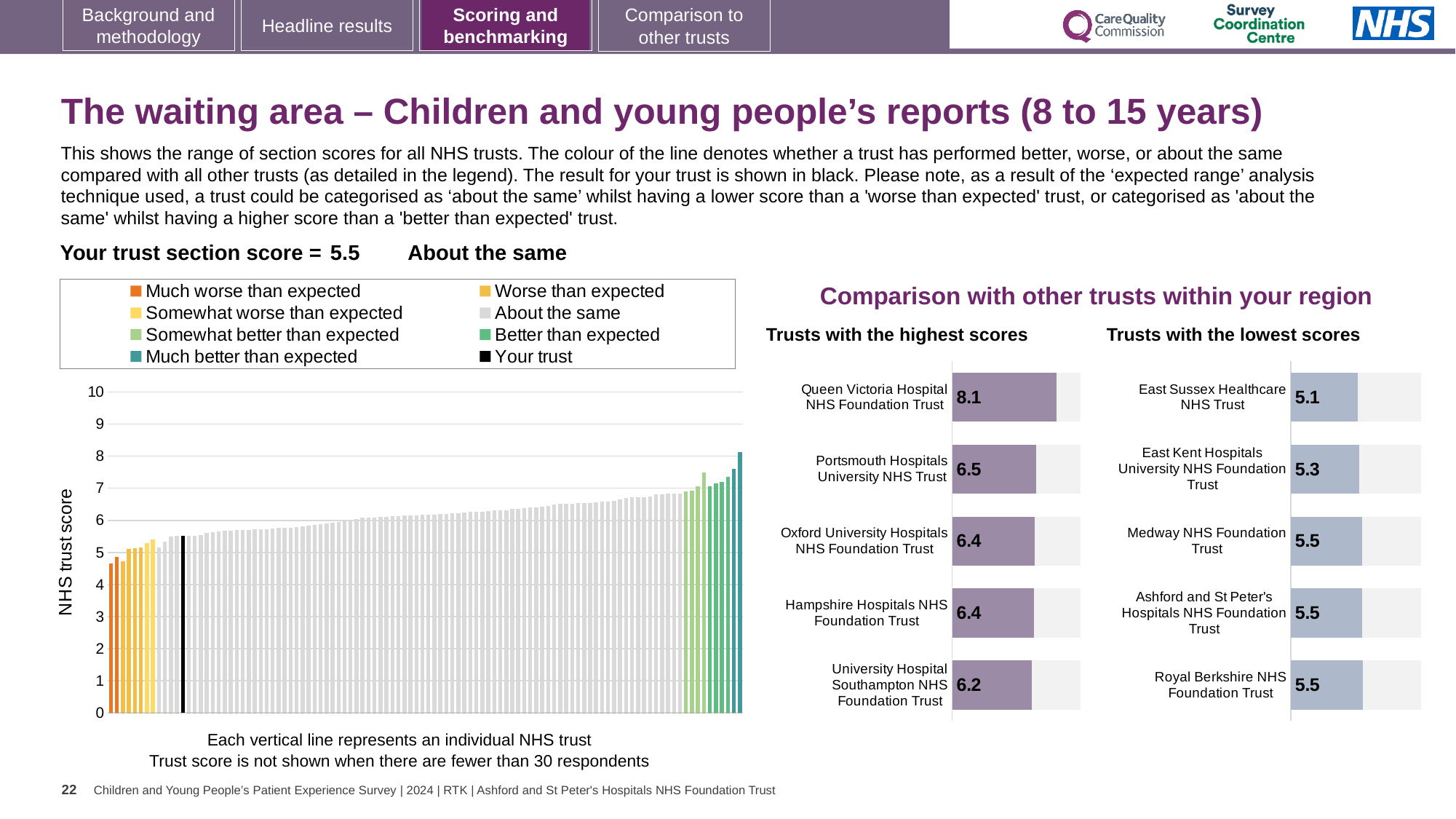
On the 'Trusts with the lowest scores' chart, what is the difference between the scores of Royal Berkshire NHS Foundation Trust and East Sussex Healthcare NHS Trust? 0.4 On the 'Trusts with the lowest scores' chart, how many trusts are listed? 5 On the 'Trusts with the highest scores' chart, what is the difference between the scores of Queen Victoria Hospital NHS Foundation Trust and Portsmouth Hospitals University NHS Trust? 1.6 On the 'Trusts with the highest scores' chart, which trust has the highest score? Queen Victoria Hospital NHS Foundation Trust On the 'Trusts with the lowest scores' chart, which trust has the lowest score? East Sussex Healthcare NHS Trust On the large 'NHS trust score' chart on the left, do the bar values rise or fall from left to right? rise On the 'Trusts with the highest scores' chart, which has the higher score: Portsmouth Hospitals University NHS Trust or Oxford University Hospitals NHS Foundation Trust? Portsmouth Hospitals University NHS Trust On the 'Trusts with the highest scores' chart, what is the score for Queen Victoria Hospital NHS Foundation Trust? 8.1 On the 'Trusts with the lowest scores' chart, what is the score for East Kent Hospitals University NHS Foundation Trust? 5.3 On the large 'NHS trust score' chart on the left, is the value of the lowest (leftmost) bar greater or less than 5? less How many entries does the legend above the large 'NHS trust score' chart list? 8 On the 'Trusts with the highest scores' chart, what is the score for University Hospital Southampton NHS Foundation Trust? 6.2